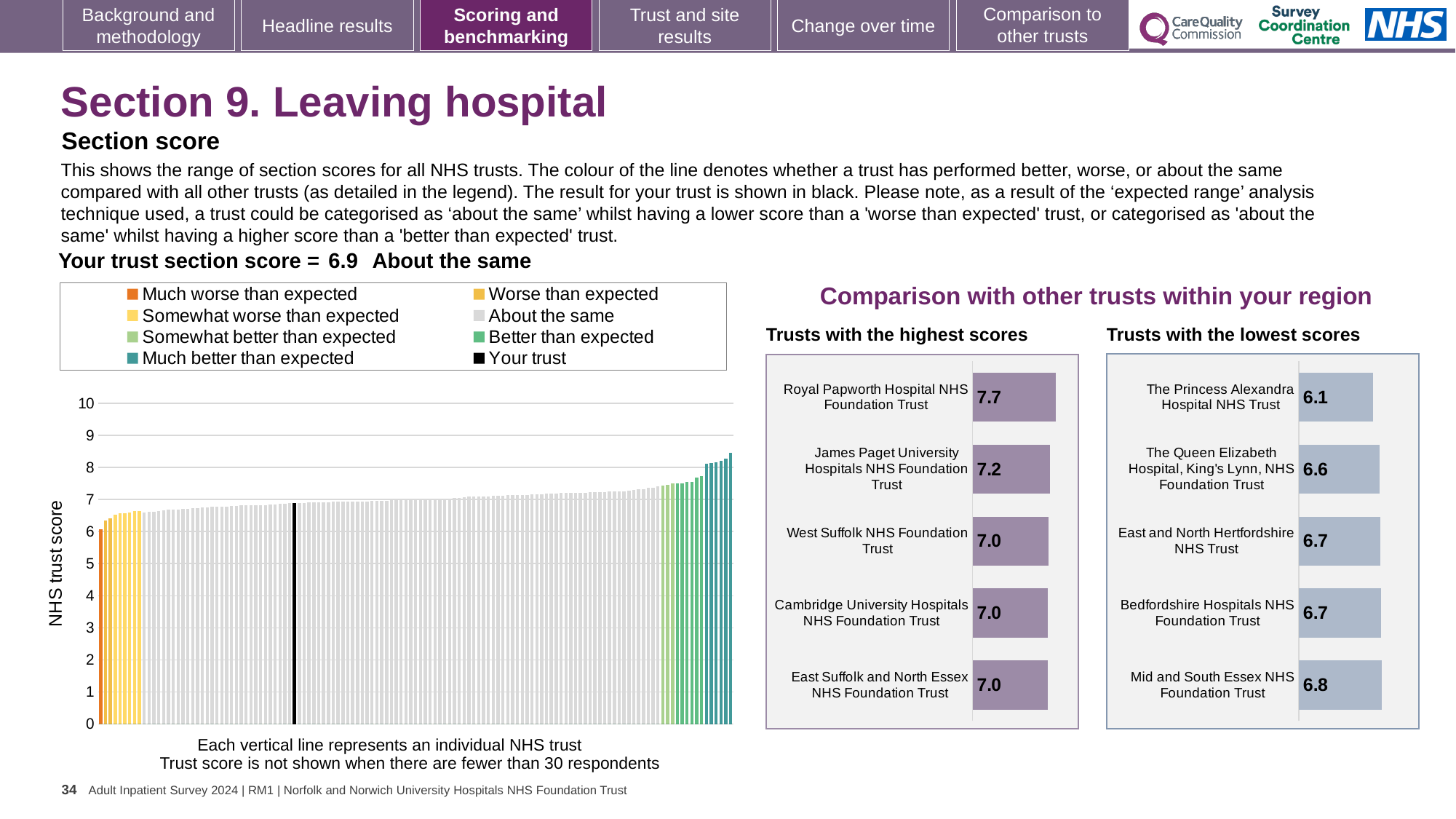
What kind of chart is the large 'NHS trust score' chart on the left of the slide? Bar chart In the 'Trusts with the lowest scores' chart, what is the difference between the scores of Mid and South Essex NHS Foundation Trust and The Princess Alexandra Hospital NHS Trust? 0.7 How many trusts are shown in the 'Trusts with the highest scores' chart? 5 In the 'Trusts with the highest scores' chart, which trust has the highest score? Royal Papworth Hospital NHS Foundation Trust In the 'Trusts with the highest scores' chart, what is the score for Royal Papworth Hospital NHS Foundation Trust? 7.7 In the 'Trusts with the lowest scores' chart, what is the score for The Princess Alexandra Hospital NHS Trust? 6.1 In the 'Trusts with the lowest scores' chart, which trust has the lowest score? The Princess Alexandra Hospital NHS Trust In the 'Trusts with the highest scores' chart, what is the difference between the scores of Royal Papworth Hospital NHS Foundation Trust and James Paget University Hospitals NHS Foundation Trust? 0.5 In the 'NHS trust score' chart, do the bar values rise or fall from left to right? Rise How many entries does the legend of the 'NHS trust score' chart list? 8 In the 'Trusts with the lowest scores' chart, which has the higher score: The Queen Elizabeth Hospital, King's Lynn, NHS Foundation Trust or East and North Hertfordshire NHS Trust? East and North Hertfordshire NHS Trust In the 'NHS trust score' chart, what is the section score for your trust (the black bar)? 6.9